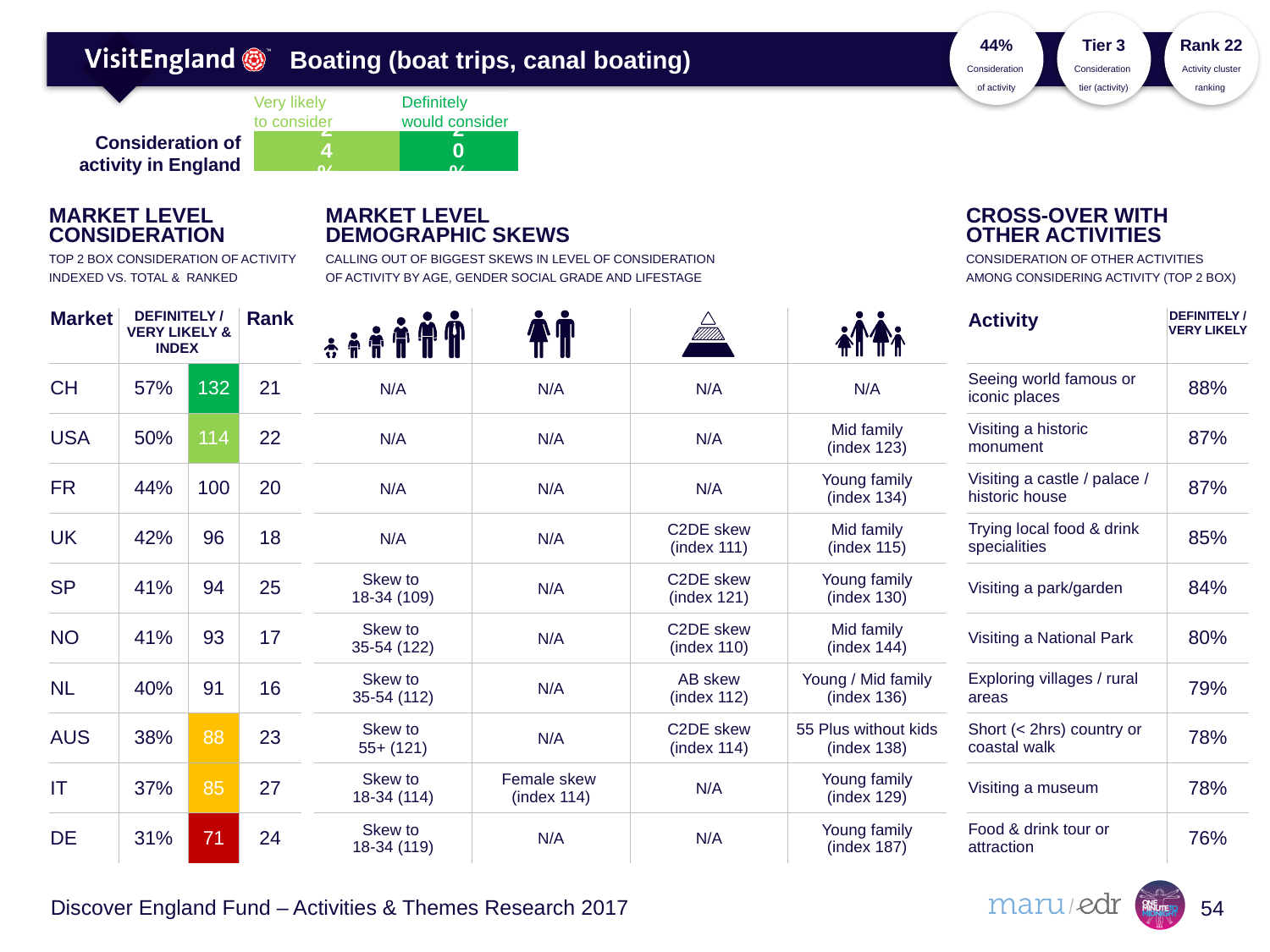
In the 'Consideration of activity in England' chart, what is the value for 'Very likely to consider'? 24% In the 'Consideration of activity in England' chart, what is the total of the stacked bar? 44% What kind of chart is the 'Consideration of activity in England' chart? bar chart In the 'Consideration of activity in England' chart, what is the value for 'Definitely would consider'? 20% In the 'Consideration of activity in England' chart, what is the difference between 'Very likely to consider' and 'Definitely would consider'? 4% In the 'Consideration of activity in England' chart, which is larger: 'Very likely to consider' or 'Definitely would consider'? Very likely to consider What are the two legend entries of the 'Consideration of activity in England' chart? Very likely to consider; Definitely would consider How many series does the 'Consideration of activity in England' chart show? 2